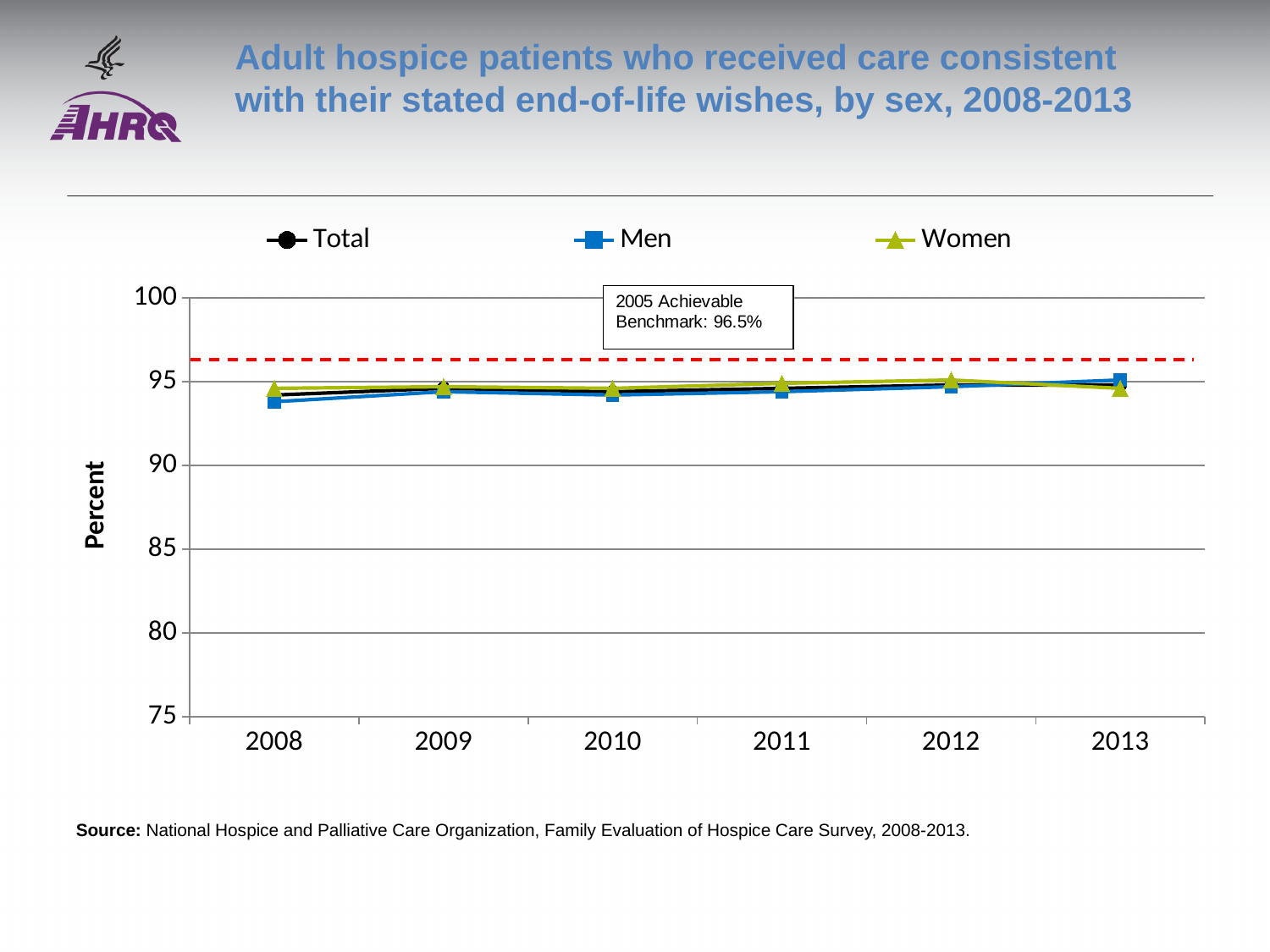
What kind of chart is shown on the slide? line chart What is the 2005 Achievable Benchmark value shown on the chart? 96.5% In which year is the value for Men lowest? 2008 In 2008, which is higher, Men or Women? Women Is the value for Total in 2010 greater or less than 95? less Is the value for Women in 2008 greater or less than 90? greater Which series are listed in the legend? Total, Men, Women What is the label on the y axis? Percent How many series does the legend list? 3 Does the Men series rise or fall overall from 2008 to 2013? rise Is the value for Men in 2008 greater or less than 95? less How many years are plotted along the x axis? 6